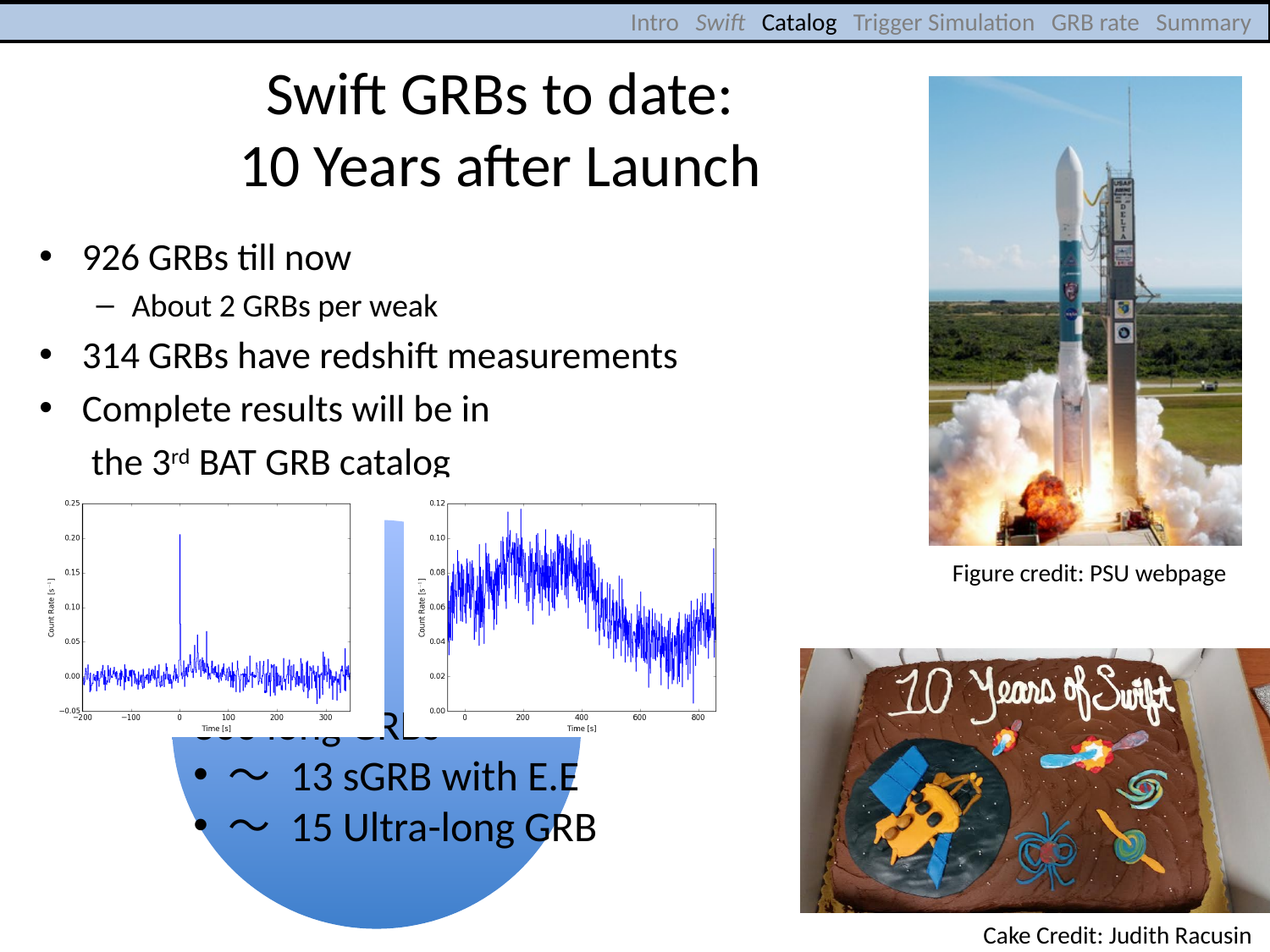
In the left chart, is the peak count rate at time 0 greater or less than 0.15? greater In the right chart, is the count rate higher around time 200 or around time 700? around time 200 In the right chart, is the count rate around time 700 greater or less than 0.08? less What is the x-axis label of the right chart? Time [s] What kind of chart is the left chart (x axis from -200 to 300)? line chart In the left chart, is the count rate at time -100 greater or less than 0.05? less In the right chart, do the count rates fall or rise between time 400 and time 700? fall What is the y-axis label of the left chart? Count Rate [s⁻¹] What kind of chart is the right chart (x axis from 0 to 800)? line chart How many data series are plotted in the left chart? 1